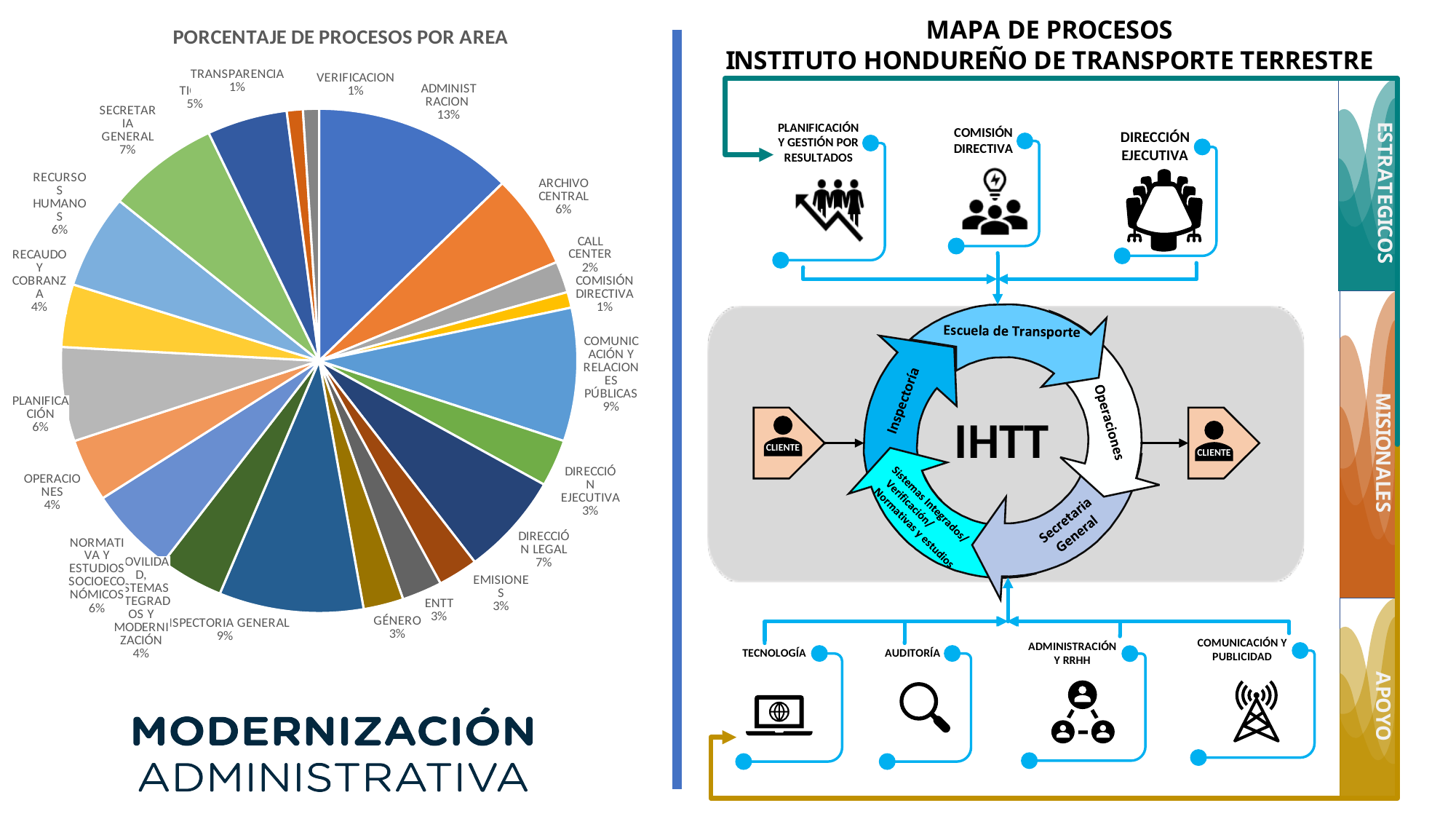
In the pie chart, what is the difference in percentage points between ADMINISTRACION and ARCHIVO CENTRAL? 7 In the pie chart, which is larger: SECRETARIA GENERAL or OPERACIONES? SECRETARIA GENERAL In the pie chart, what percentage is shown for RECURSOS HUMANOS? 6% In the pie chart, what percentage is shown for DIRECCIÓN LEGAL? 7% Which area has the largest share in the pie chart? ADMINISTRACION In the pie chart, what percentage is shown for INSPECTORIA GENERAL? 9% In the pie chart, what percentage is shown for CALL CENTER? 2% What type of chart is 'PORCENTAJE DE PROCESOS POR AREA'? Pie chart In the pie chart, what percentage is shown for GÉNERO? 3% In the pie chart, which is larger: COMUNICACIÓN Y RELACIONES PÚBLICAS or DIRECCIÓN EJECUTIVA? COMUNICACIÓN Y RELACIONES PÚBLICAS In the pie chart, what percentage is shown for ADMINISTRACION? 13% What is the title of the pie chart on the left of the slide? PORCENTAJE DE PROCESOS POR AREA